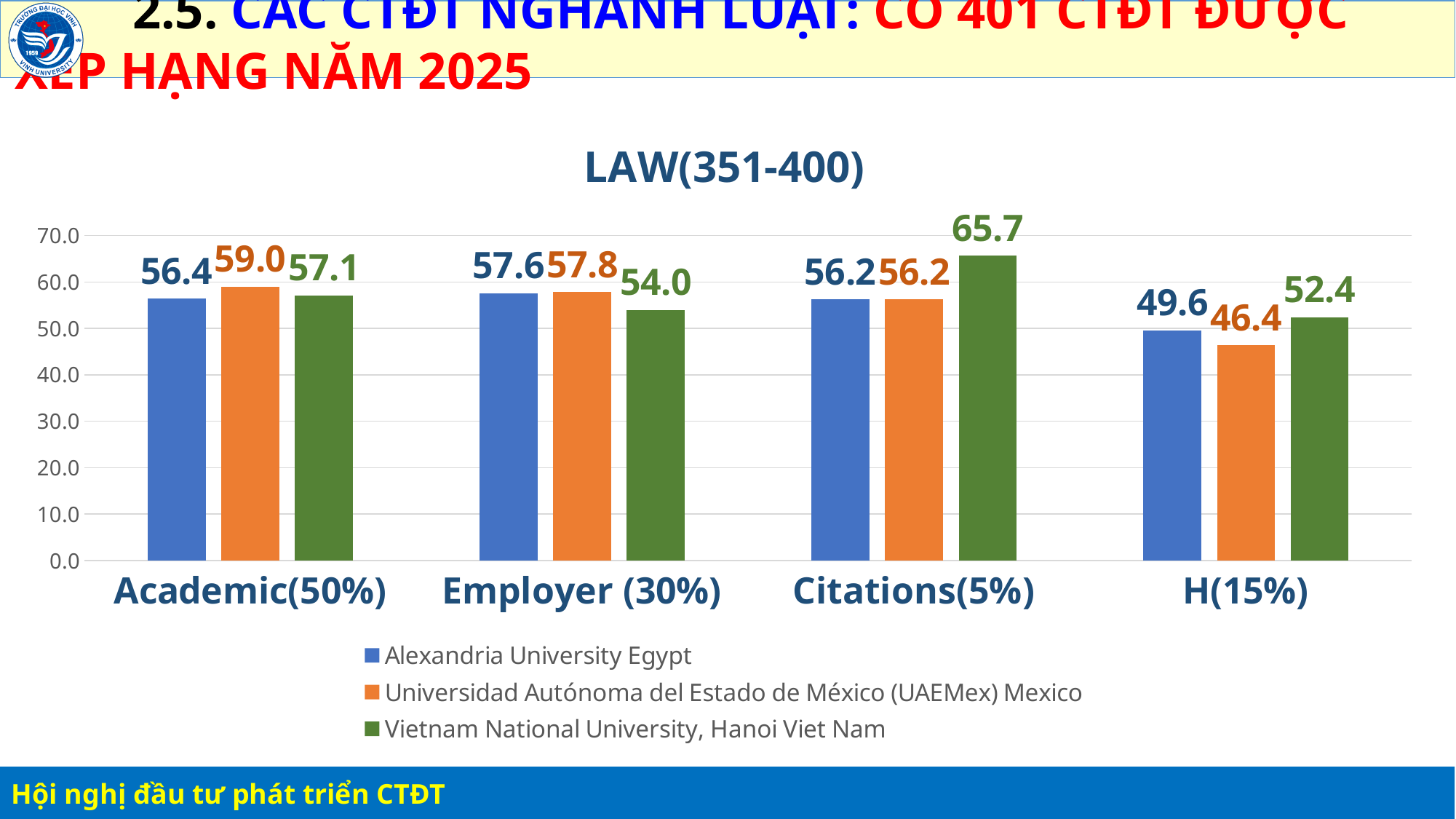
What is the value for Vietnam National University, Hanoi Viet Nam in the Citations(5%) category? 65.7 What is the value for Alexandria University Egypt in the H(15%) category? 49.6 What is the value for Universidad Autónoma del Estado de México (UAEMex) Mexico in the Academic(50%) category? 59.0 What is the difference between the Universidad Autónoma del Estado de México (UAEMex) Mexico value and the Vietnam National University, Hanoi Viet Nam value in the Employer (30%) category? 3.8 What is the difference between the Vietnam National University, Hanoi Viet Nam value and the Alexandria University Egypt value in the Citations(5%) category? 9.5 In the Academic(50%) category, which is larger: the value for Alexandria University Egypt or the value for Vietnam National University, Hanoi Viet Nam? Vietnam National University, Hanoi Viet Nam How many series does the legend list? 3 Is the value for Universidad Autónoma del Estado de México (UAEMex) Mexico in the H(15%) category greater or less than 50.0? less What is the title of the chart? LAW(351-400) Which series has the highest value in the Citations(5%) category? Vietnam National University, Hanoi Viet Nam Which series has the lowest value in the H(15%) category? Universidad Autónoma del Estado de México (UAEMex) Mexico How many categories are shown on the x axis? 4